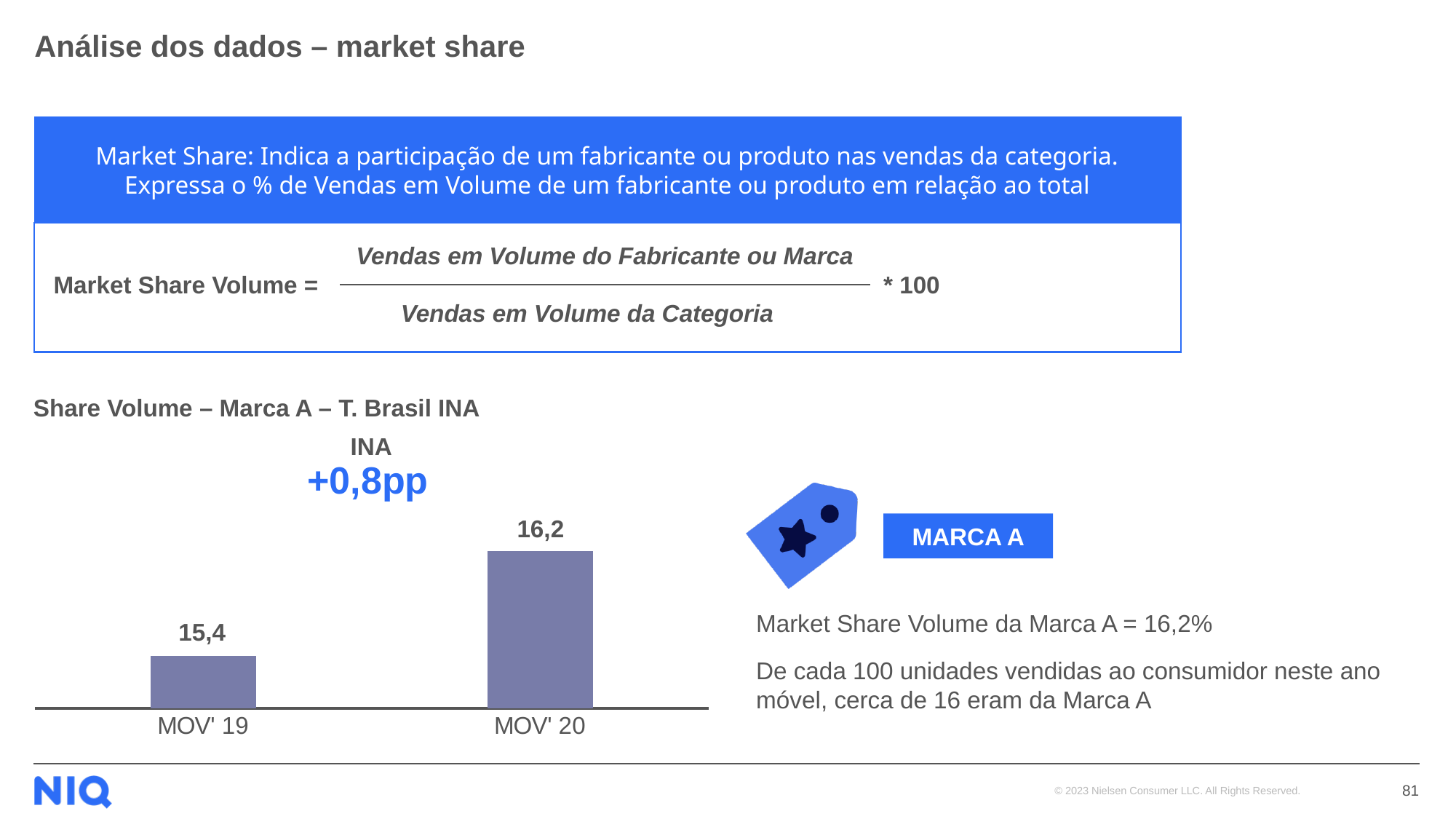
What is the value for MOV' 20 in the Share Volume – Marca A – T. Brasil INA chart? 16,2 Is the value for MOV' 19 or MOV' 20 larger in the Share Volume – Marca A chart? MOV' 20 What is the difference between the MOV' 20 and MOV' 19 values in the Share Volume – Marca A chart? 0,8 What kind of chart is the Share Volume – Marca A – T. Brasil INA chart? Bar chart Which period has the lowest value in the Share Volume – Marca A chart? MOV' 19 How many bars are plotted in the Share Volume – Marca A chart? 2 What is the title of the bar chart on the slide? Share Volume – Marca A – T. Brasil INA Do the values rise or fall from MOV' 19 to MOV' 20 in the Share Volume – Marca A chart? Rise Which period has the highest value in the Share Volume – Marca A chart? MOV' 20 What is the value for MOV' 19 in the Share Volume – Marca A – T. Brasil INA chart? 15,4 What change in percentage points is annotated above the Share Volume – Marca A chart? +0,8pp